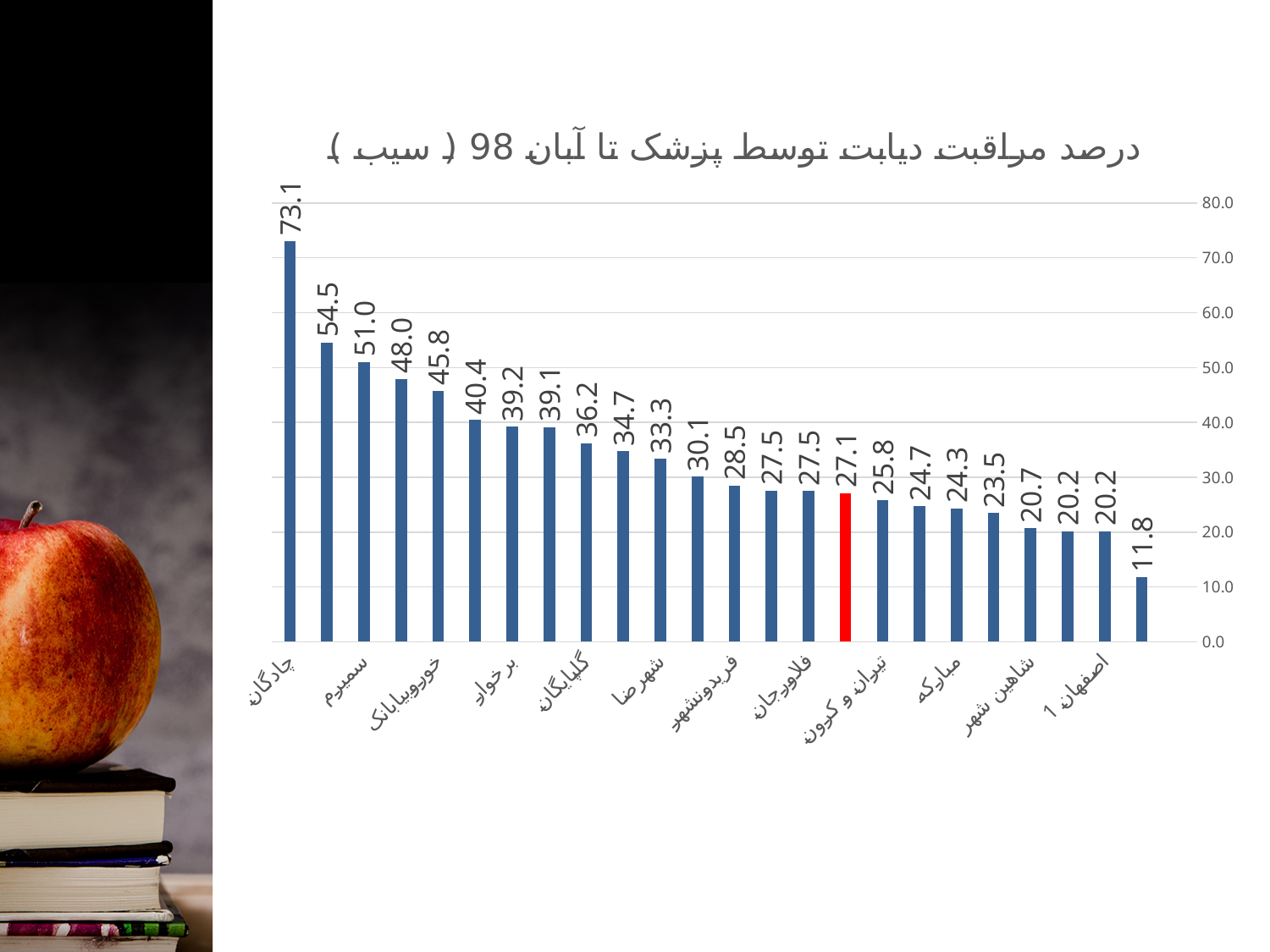
What is the value of the red bar? 27.1 Which category has the highest value? چادگان What is the value for فلاورجان? 27.5 Do the values rise or fall from left to right along the x axis? fall What is the value for اصفهان 1? 20.2 What kind of chart is shown on the slide? bar chart What is the difference between the values for چادگان and اصفهان 1? 52.9 What is the difference between the highest value (73.1) and the lowest value (11.8)? 61.3 What is the value for چادگان? 73.1 Is the value of the red bar greater or less than 30.0? less How many bars are plotted in the chart? 24 What is the lowest value shown in the chart? 11.8